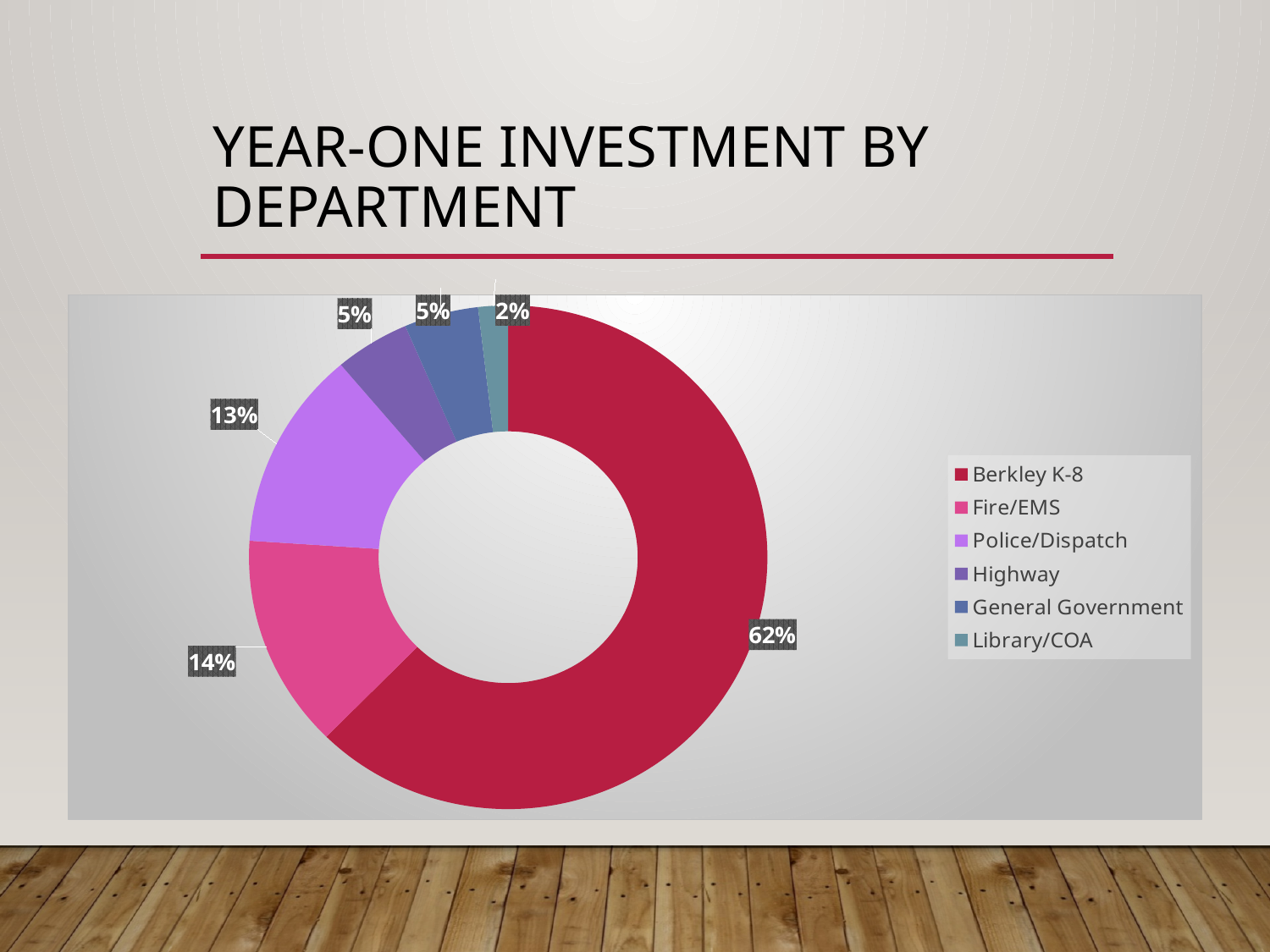
What kind of chart is shown on the slide? doughnut chart Which has a larger share, Fire/EMS or General Government? Fire/EMS Which department receives the largest share of the year-one investment? Berkley K-8 What percentage is shown for Police/Dispatch? 13% What is the title of the slide? Year-One Investment by Department How many percentage points larger is the Fire/EMS share than the Police/Dispatch share? 1 What percentage is shown for Library/COA? 2% How many departments are shown in the chart? 6 Which department receives the smallest share of the year-one investment? Library/COA What percentage is shown for Highway? 5% What percentage is shown for Fire/EMS? 14% What share of the year-one investment goes to Berkley K-8? 62%